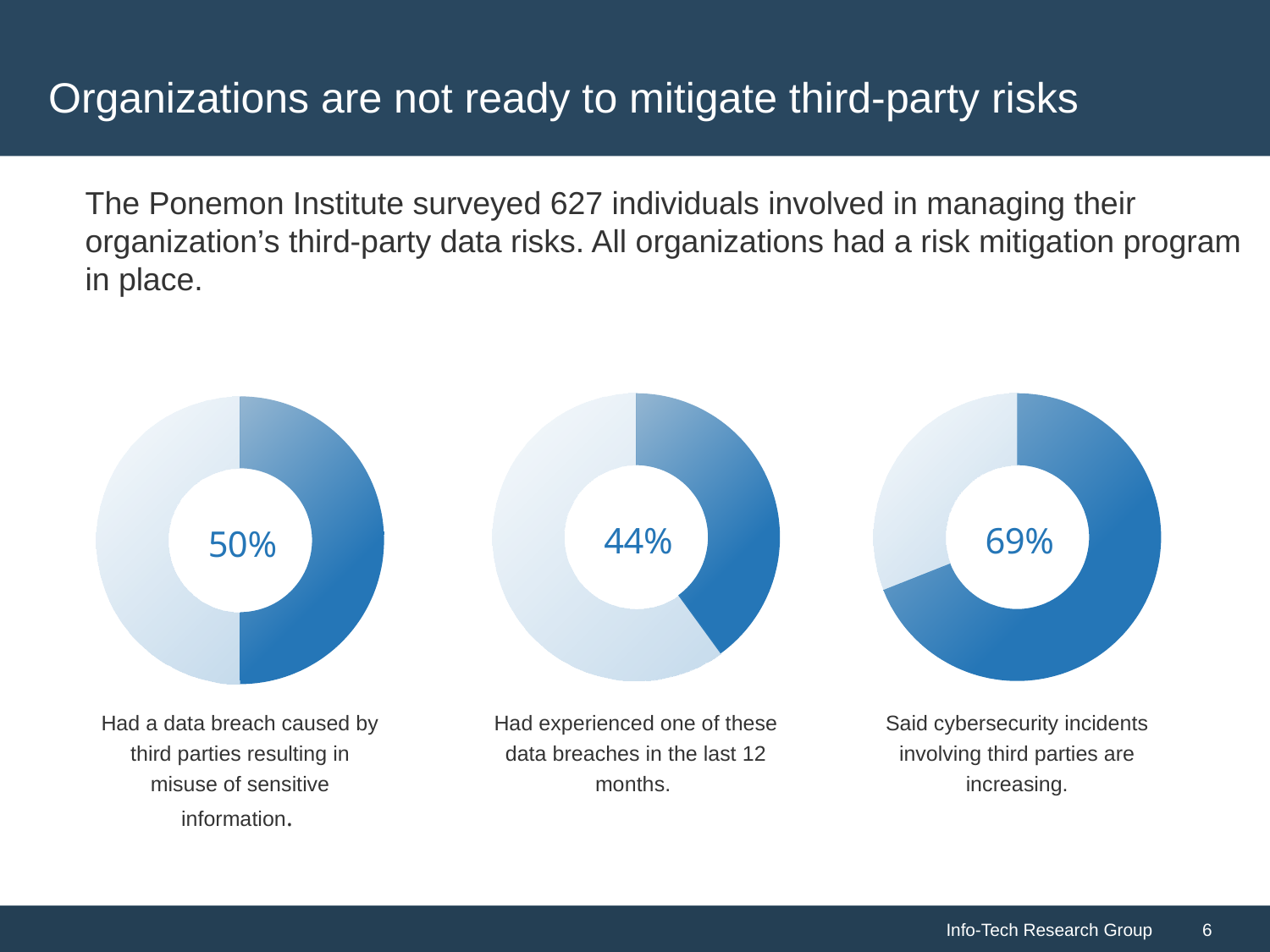
What is the difference in percentage points between the right chart (69%) and the middle chart (44%)? 25 percentage points What percentage is shown in the middle donut chart, for respondents who had experienced one of these data breaches in the last 12 months? 44% What is the difference in percentage points between the left chart (50%) and the middle chart (44%)? 6 percentage points What kind of chart is used to display the percentages on this slide? Donut (pie) chart How many donut charts are shown on the slide? 3 Which of the three donut charts shows the highest percentage? The right chart (69%), cybersecurity incidents involving third parties are increasing Which is larger: the percentage in the left chart or the percentage in the right chart? The right chart (69%) What percentage is shown in the left donut chart, for respondents who had a data breach caused by third parties resulting in misuse of sensitive information? 50% What percentage is shown in the right donut chart, for respondents who said cybersecurity incidents involving third parties are increasing? 69% In the right donut chart, what share of the ring is not highlighted in dark blue? 31% How many individuals did the Ponemon Institute survey, according to the slide text? 627 Which of the three donut charts shows the lowest percentage? The middle chart (44%), experienced one of these data breaches in the last 12 months